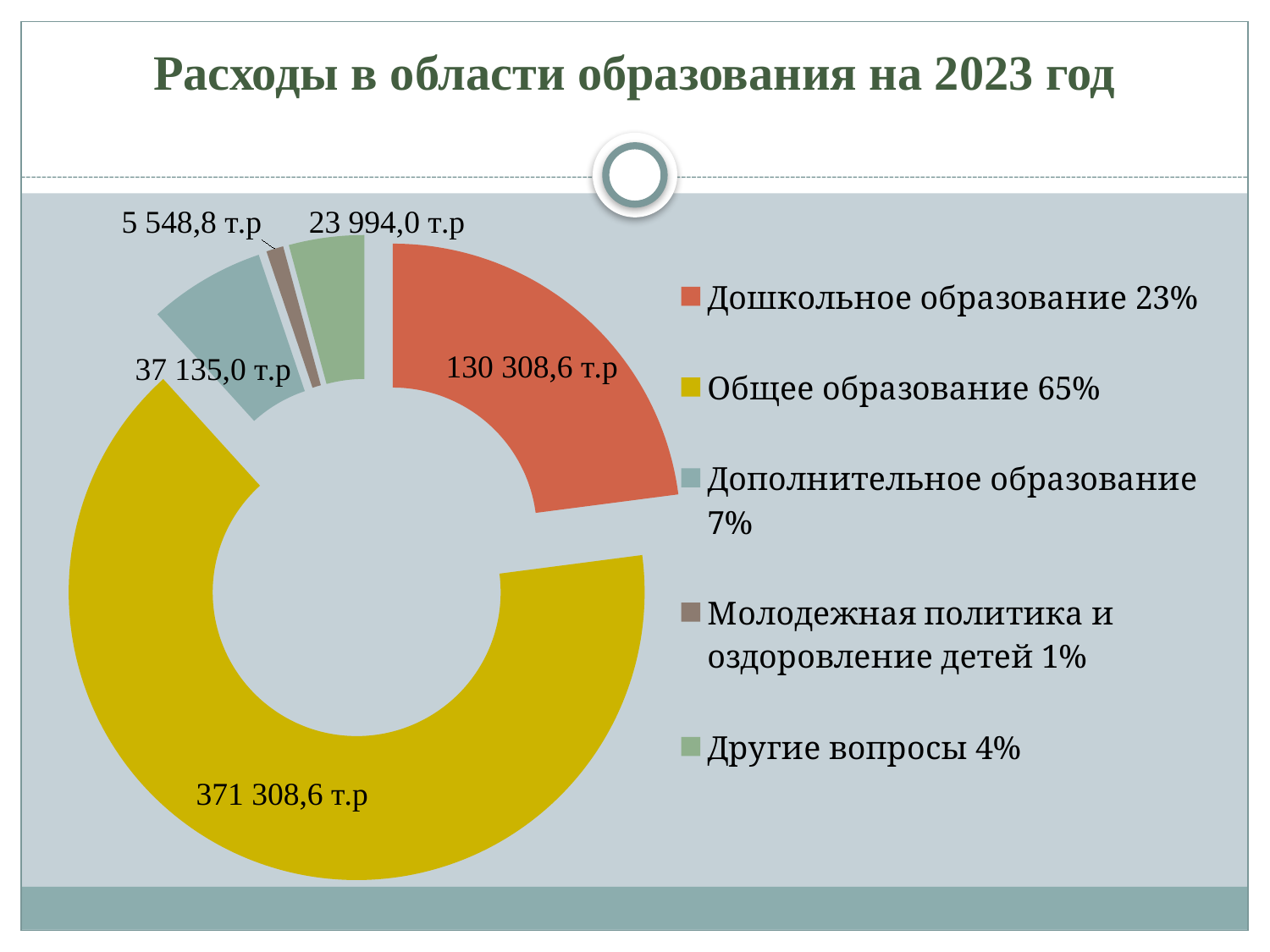
What is the value for Общее образование? 371 308,6 т.р What share of the chart does Дошкольное образование represent? 23% Which category has the smallest share of the chart? Молодежная политика и оздоровление детей What is the difference between the values for Общее образование and Дошкольное образование? 241 000,0 т.р Which category has the largest share of the chart? Общее образование What share of the chart does Дополнительное образование represent? 7% What kind of chart is shown on the slide? Doughnut (pie) chart What is the value for Другие вопросы? 23 994,0 т.р What is the value for Молодежная политика и оздоровление детей? 5 548,8 т.р What is the value for Дополнительное образование? 37 135,0 т.р How many categories does the chart show? 5 What is the value for Дошкольное образование? 130 308,6 т.р